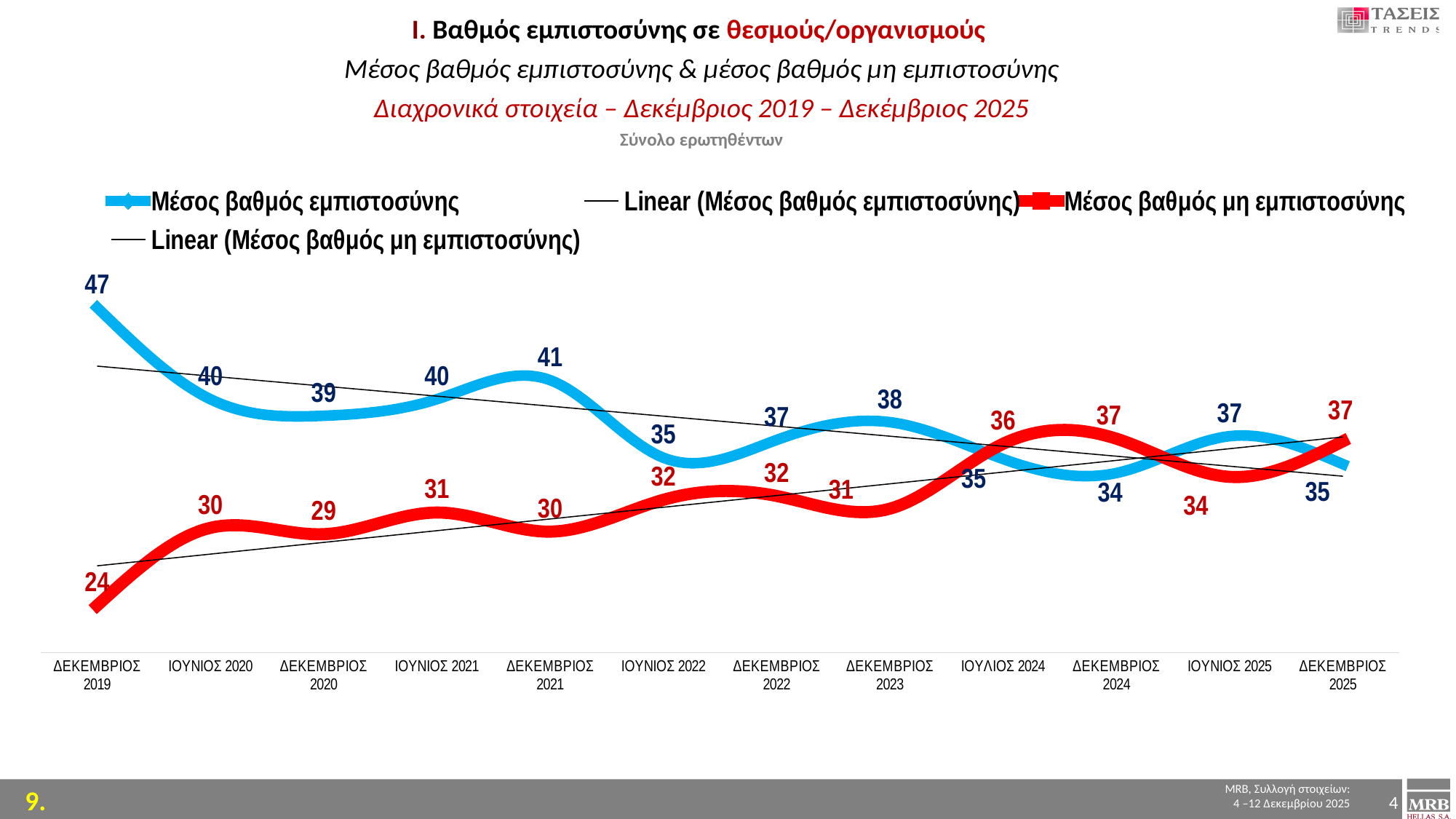
What kind of chart is shown on the slide? Line chart In which period is Μέσος βαθμός μη εμπιστοσύνης lowest? ΔΕΚΕΜΒΡΙΟΣ 2019 Does Μέσος βαθμός μη εμπιστοσύνης generally rise or fall from ΔΕΚΕΜΒΡΙΟΣ 2019 to ΔΕΚΕΜΒΡΙΟΣ 2025? Rise What is the value of Μέσος βαθμός εμπιστοσύνης for ΔΕΚΕΜΒΡΙΟΣ 2019? 47 In which period is Μέσος βαθμός εμπιστοσύνης highest? ΔΕΚΕΜΒΡΙΟΣ 2019 What is the value of Μέσος βαθμός εμπιστοσύνης for ΙΟΥΝΙΟΣ 2022? 35 In ΔΕΚΕΜΒΡΙΟΣ 2024, which is larger: Μέσος βαθμός εμπιστοσύνης or Μέσος βαθμός μη εμπιστοσύνης? Μέσος βαθμός μη εμπιστοσύνης How many time periods are shown on the x axis? 12 What is the value of Μέσος βαθμός μη εμπιστοσύνης for ΔΕΚΕΜΒΡΙΟΣ 2019? 24 How many entries does the legend list? 4 What is the difference between Μέσος βαθμός εμπιστοσύνης and Μέσος βαθμός μη εμπιστοσύνης in ΔΕΚΕΜΒΡΙΟΣ 2019? 23 What is the value of Μέσος βαθμός μη εμπιστοσύνης for ΔΕΚΕΜΒΡΙΟΣ 2025? 37